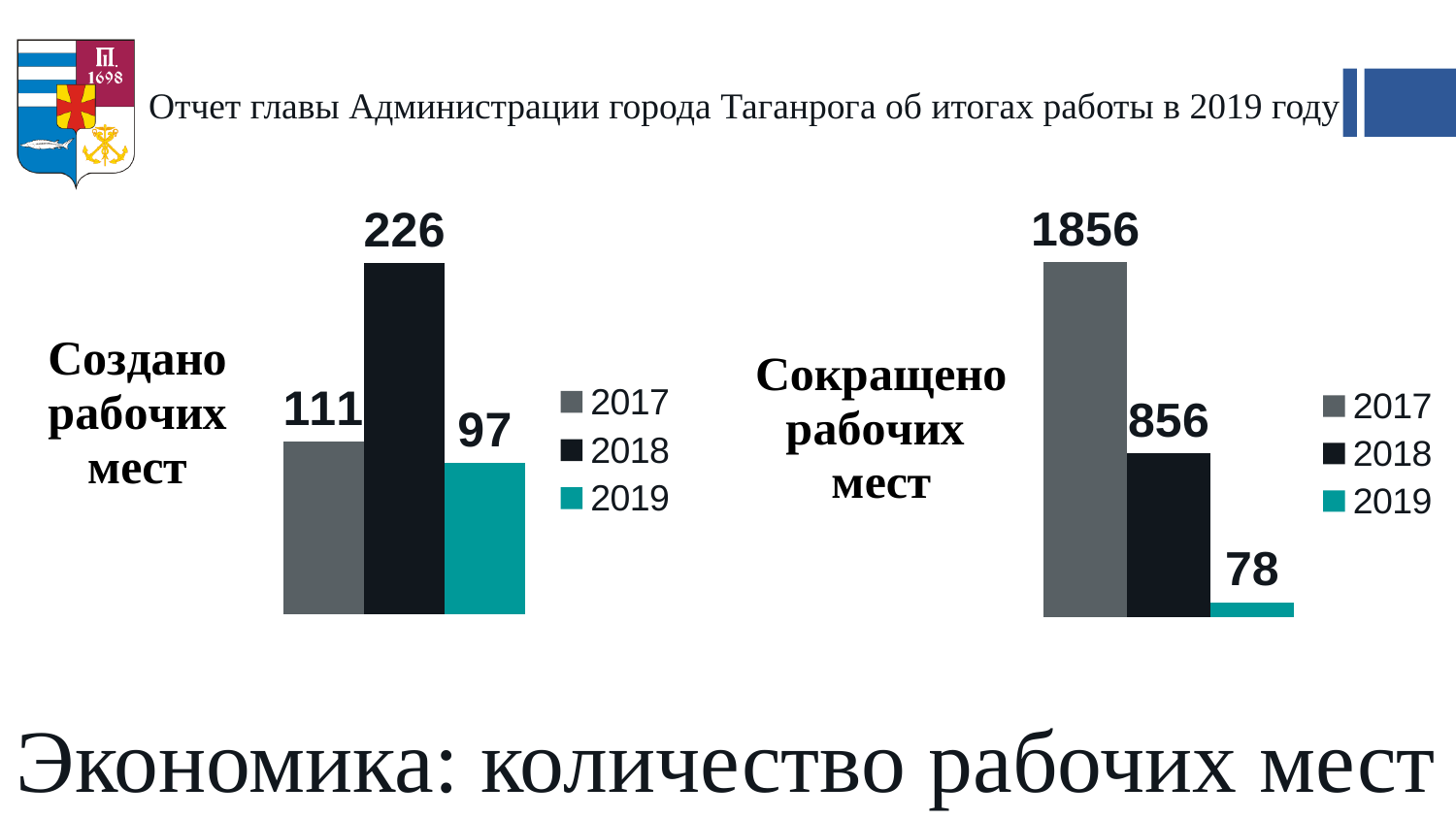
What kind of chart is the 'Создано рабочих мест' chart? Bar chart In the 'Создано рабочих мест' chart, which is larger: the value for 2017 or the value for 2019? 2017 In the 'Создано рабочих мест' chart, which year has the highest value? 2018 How many series does the legend of the 'Сокращено рабочих мест' chart list? 3 In the 'Сокращено рабочих мест' chart, do the values rise or fall from 2017 to 2019? Fall In the 'Сокращено рабочих мест' chart, which year has the lowest value? 2019 In the 'Создано рабочих мест' chart, what is the value for 2019? 97 In the 'Сокращено рабочих мест' chart, what is the value for 2017? 1856 In the 'Создано рабочих мест' chart, what is the difference between the 2018 and 2017 values? 115 In the 'Создано рабочих мест' chart, what is the value for 2018? 226 In the 'Сокращено рабочих мест' chart, what is the difference between the 2017 and 2018 values? 1000 In the 'Сокращено рабочих мест' chart, what is the value for 2019? 78